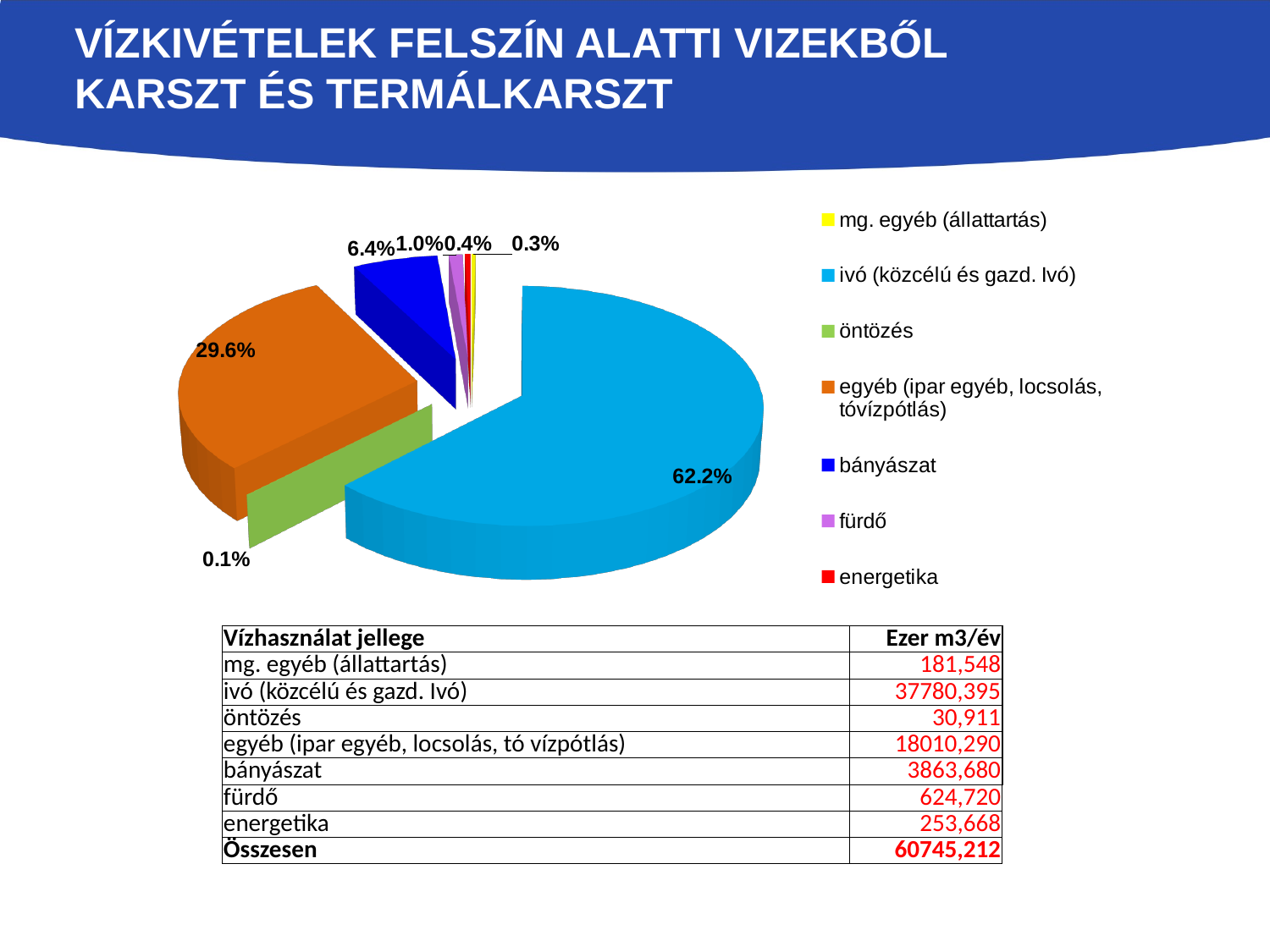
What percentage is shown for the 'öntözés' slice? 0.1% What colour is the 'energetika' slice in the pie chart? red Which category has the largest slice of the pie? ivó (közcélú és gazd. Ivó) What share of the pie does the 'ivó (közcélú és gazd. Ivó)' slice represent? 62.2% What percentage is shown for the 'bányászat' slice? 6.4% What is the difference in percentage points between the 'ivó (közcélú és gazd. Ivó)' slice and the 'egyéb (ipar egyéb, locsolás, tóvízpótlás)' slice? 32.6 percentage points What kind of chart is shown on the slide? pie chart How many entries does the legend of the pie chart list? 7 What percentage is shown for the 'fürdő' slice? 1.0% What share of the pie does the 'egyéb (ipar egyéb, locsolás, tóvízpótlás)' slice represent? 29.6% Which slice is larger: 'bányászat' or 'fürdő'? bányászat Which category has the smallest slice of the pie? öntözés